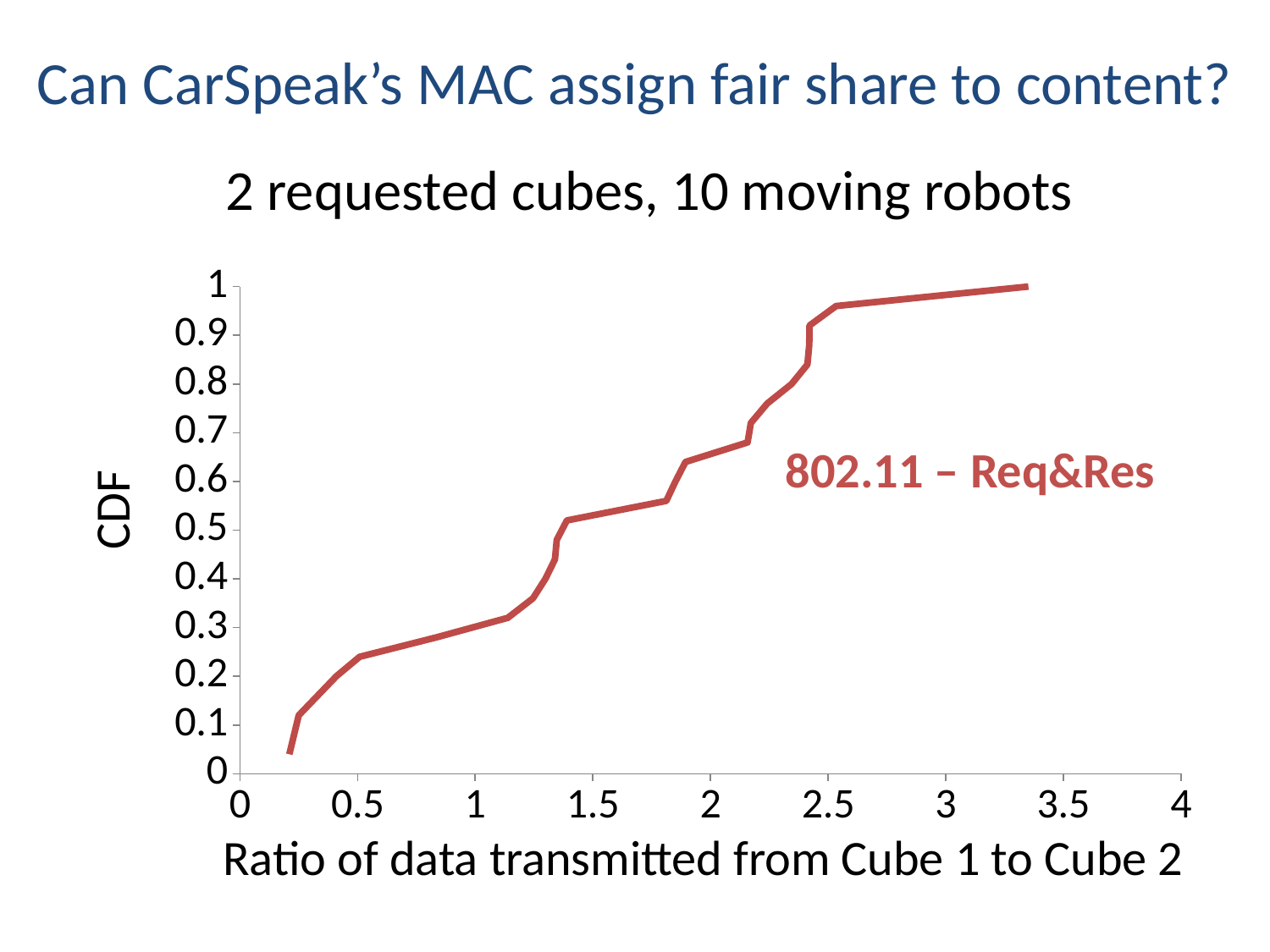
Is the CDF value at a ratio of 1 greater or less than 0.5? less How many series are plotted on the chart? 1 Is the CDF value at a ratio of 2.5 greater or less than 0.9? greater Is the CDF value at a ratio of 3 greater or less than 0.9? greater Does the CDF curve rise or fall as the ratio on the x axis increases? rise What is the label of the x axis? Ratio of data transmitted from Cube 1 to Cube 2 What kind of chart is shown on the slide? line chart What is the name of the series plotted on the chart? 802.11 – Req&Res